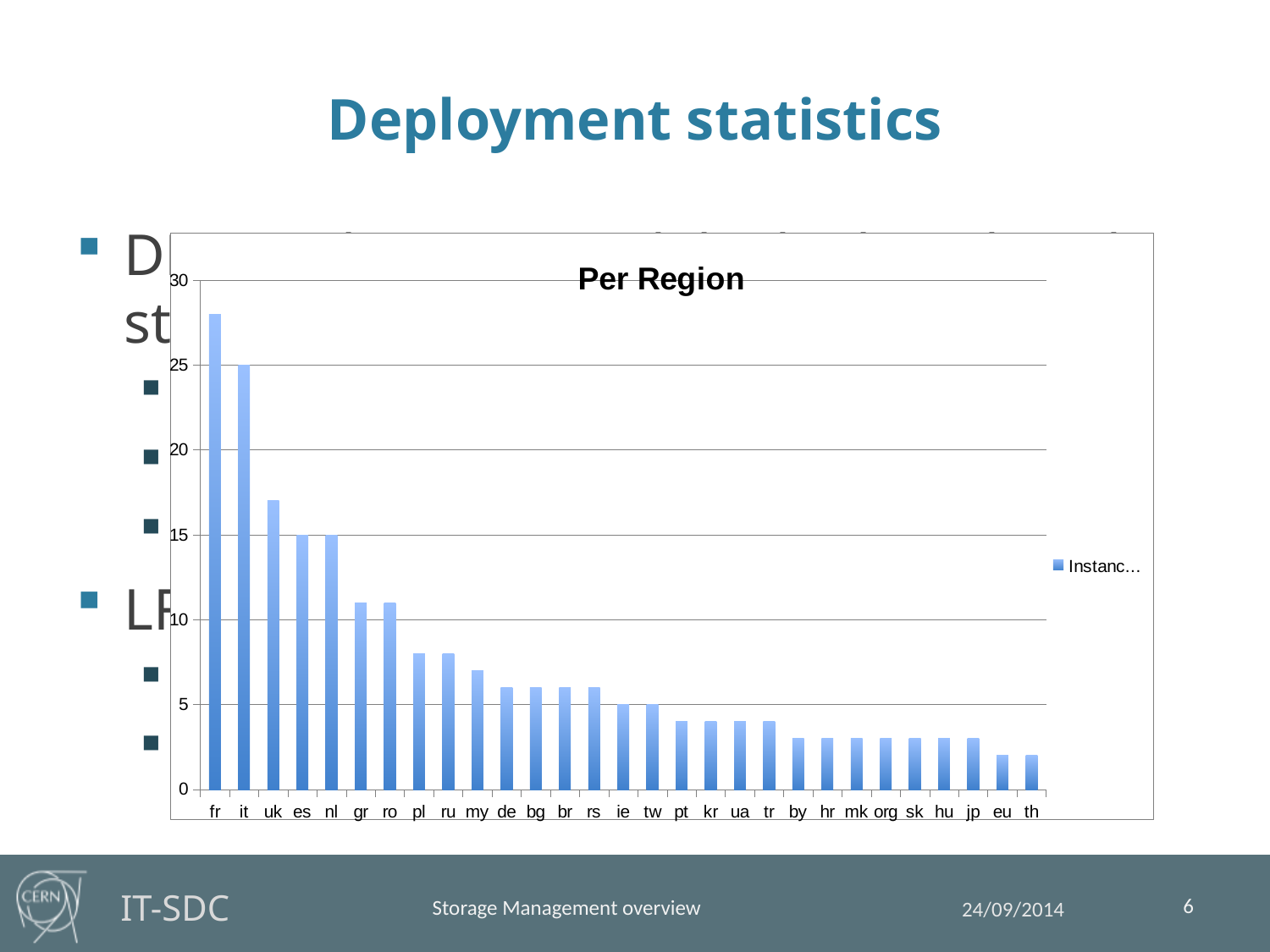
How many regions are shown on the x axis? 29 What is the value for it? 25 Is the value for pl greater or less than 10? less Is the value for uk greater or less than 15? greater What is the value for es? 15 Which is larger, the value for uk or the value for nl? uk What is the title of the chart? Per Region Is the value for fr greater or less than 25? greater What type of chart is shown on the slide? bar chart Which region has the highest value in the chart? fr What is the value for ie? 5 What is the difference between the values for it and es? 10